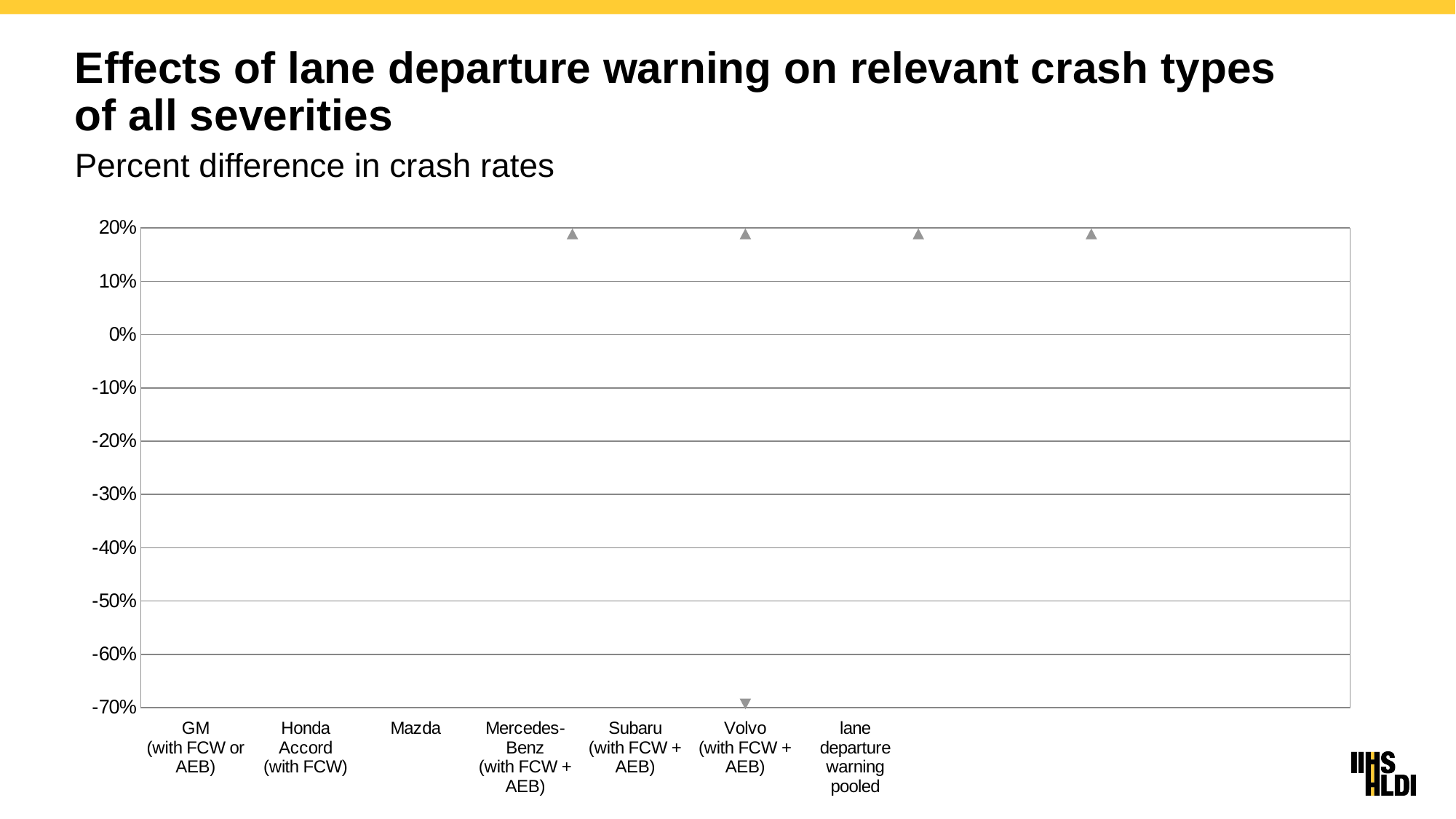
Which category on the x axis has no parenthetical note about FCW or AEB? Mazda What does the subtitle above the chart say is being plotted? Percent difference in crash rates What is the interval between consecutive tick marks on the chart's y axis? 10% What is the highest value shown on the chart's y axis? 20% What is the title of the slide containing the chart? Effects of lane departure warning on relevant crash types of all severities How many categories are listed along the x axis of the chart? 7 What is the lowest value shown on the chart's y axis? -70% What is the label of the first category on the x axis of the chart? GM (with FCW or AEB) What is the label of the last category on the x axis of the chart? lane departure warning pooled